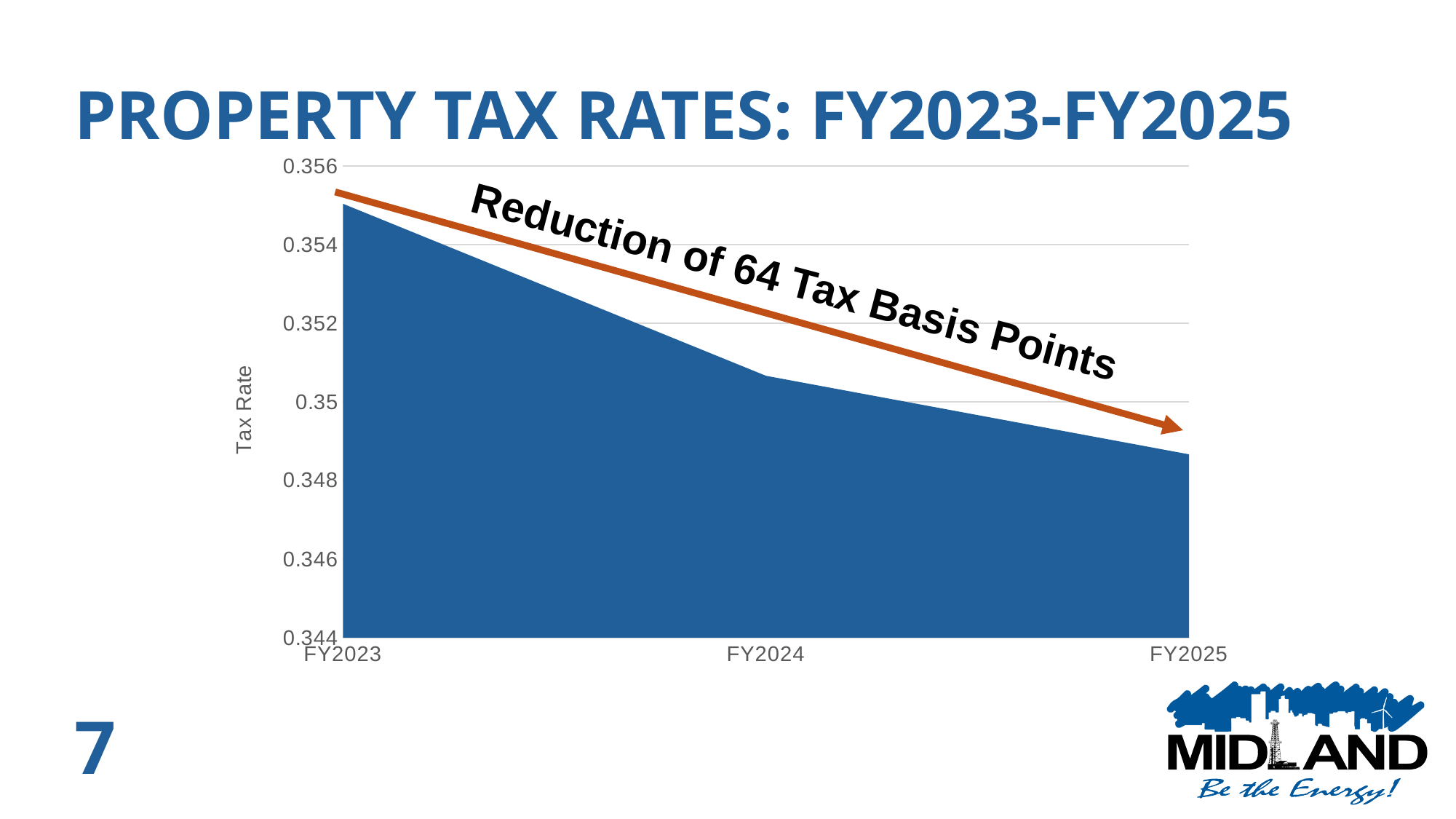
Do the tax rates rise or fall from FY2023 to FY2025? Fall Which fiscal year has the lowest tax rate? FY2025 Which fiscal year has the highest tax rate? FY2023 Is the tax rate for FY2025 greater or less than 0.348? greater What is the title of the chart on the slide? PROPERTY TAX RATES: FY2023-FY2025 Is the tax rate for FY2023 greater or less than 0.354? greater Is the tax rate for FY2025 greater or less than 0.35? less What kind of chart is shown on the slide? Area chart Which is larger, the tax rate for FY2023 or for FY2025? FY2023 What does the annotation above the shaded area say? Reduction of 64 Tax Basis Points How many fiscal years are plotted on the x axis? 3